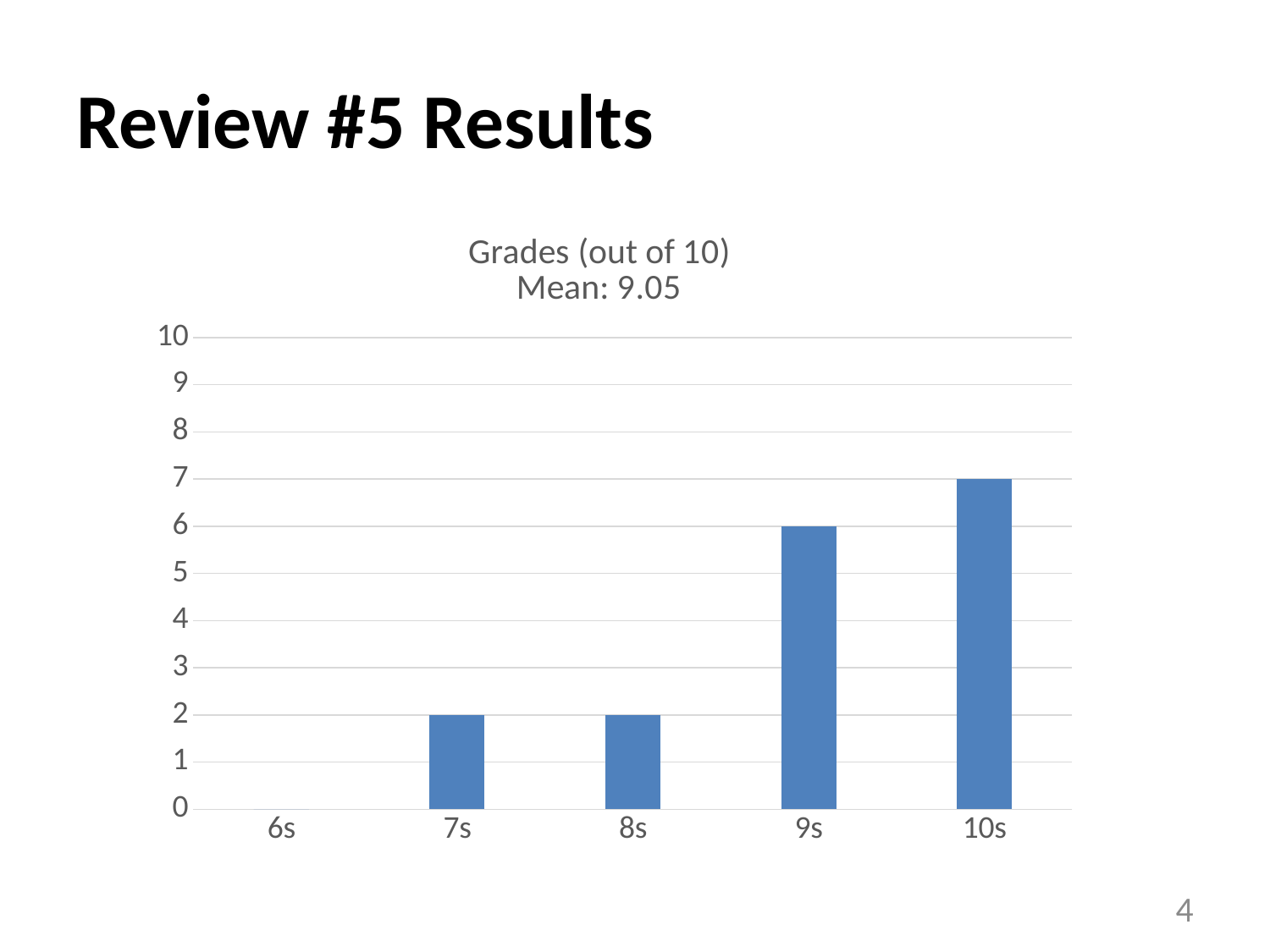
What mean value is stated in the chart title? 9.05 What type of chart is shown on the slide? bar chart Which category has the highest value? 10s What is the value for 9s? 6 What is the value for 6s? 0 Which is larger, the value for 9s or the value for 8s? 9s Which category has the lowest value? 6s What is the difference between the values for 9s and 8s? 4 How many categories are shown on the x axis? 5 What is the value for 10s? 7 What is the value for 7s? 2 What is the difference between the values for 10s and 9s? 1